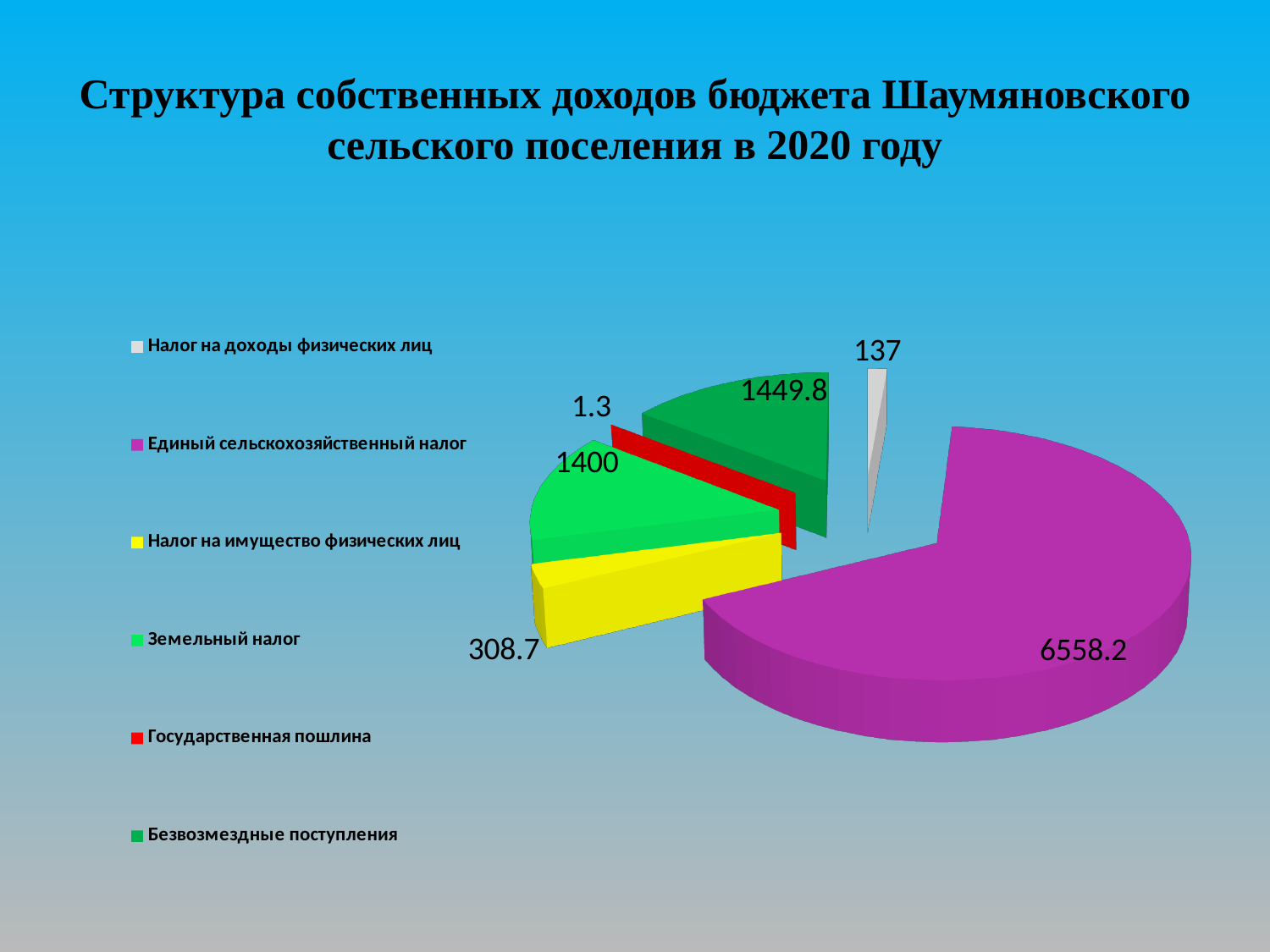
What is the value for Налог на имущество физических лиц? 308.7 What is the value for Налог на доходы физических лиц? 137 What is the value for Единый сельскохозяйственный налог? 6558.2 What is the difference between the values for Безвозмездные поступления and Земельный налог? 49.8 What colour is the slice for Государственная пошлина? Red What is the value for Земельный налог? 1400 Which category has the largest slice of the pie? Единый сельскохозяйственный налог What type of chart is shown on the slide? Pie chart How many categories does the pie chart show? 6 What is the value for Безвозмездные поступления? 1449.8 Which category has the smallest slice of the pie? Государственная пошлина Which is larger: Налог на имущество физических лиц or Налог на доходы физических лиц? Налог на имущество физических лиц